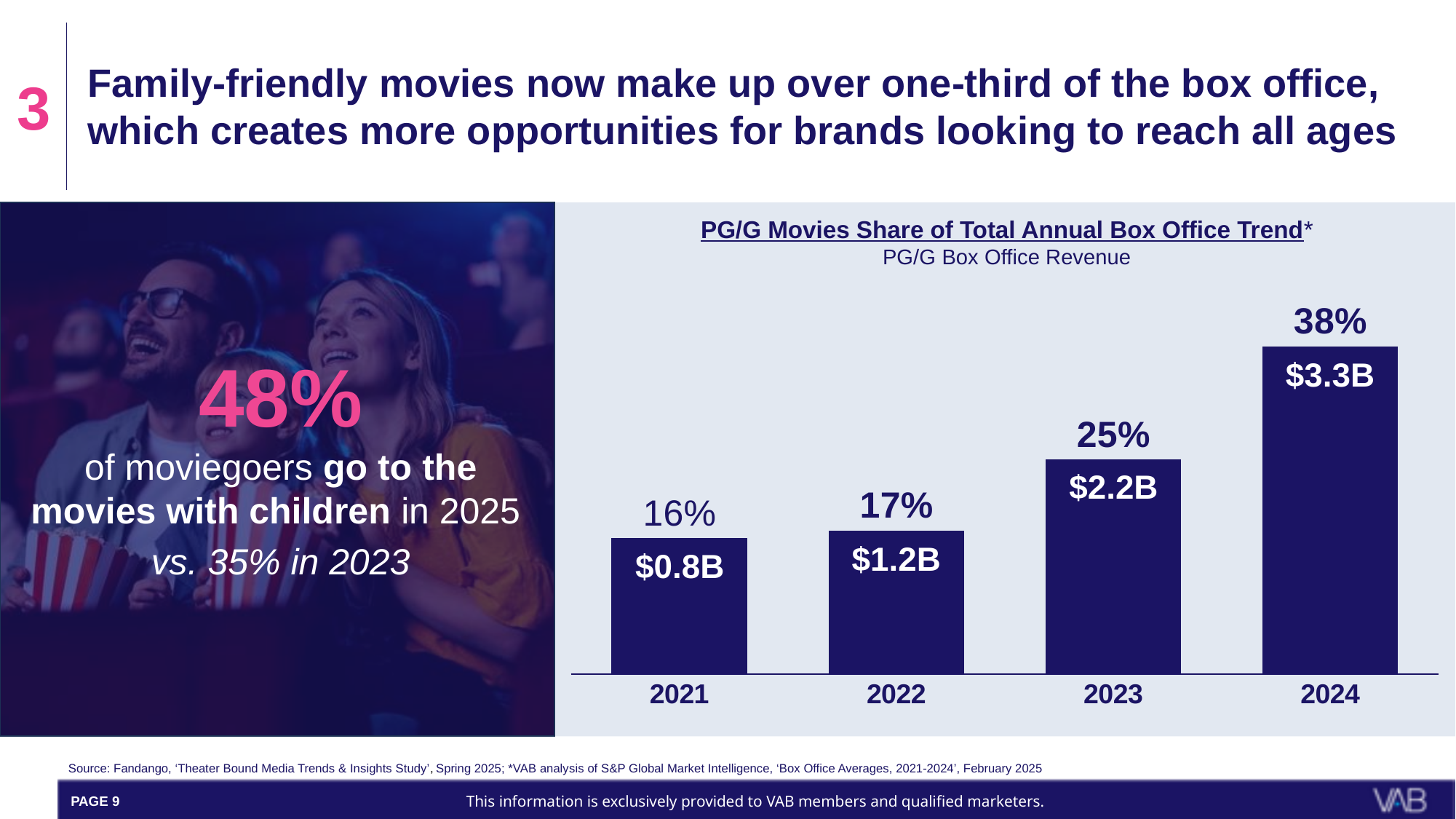
What was the PG/G box office revenue in 2022? $1.2B How many years are shown in the chart? 4 What type of chart is used to show the PG/G movies share of total annual box office trend? Bar chart What was the PG/G movies share of total annual box office in 2024? 38% What was the PG/G movies share of total annual box office in 2021? 16% Does the PG/G share of total annual box office rise or fall from 2021 to 2024? Rise Which year had a larger PG/G box office revenue, 2022 or 2023? 2023 Which year has the highest PG/G share of total annual box office? 2024 Which year has the lowest PG/G box office revenue? 2021 What is the difference in PG/G box office revenue between 2024 and 2021? $2.5B By how many percentage points did the PG/G share of box office increase from 2023 to 2024? 13 percentage points What was the PG/G box office revenue in 2023? $2.2B